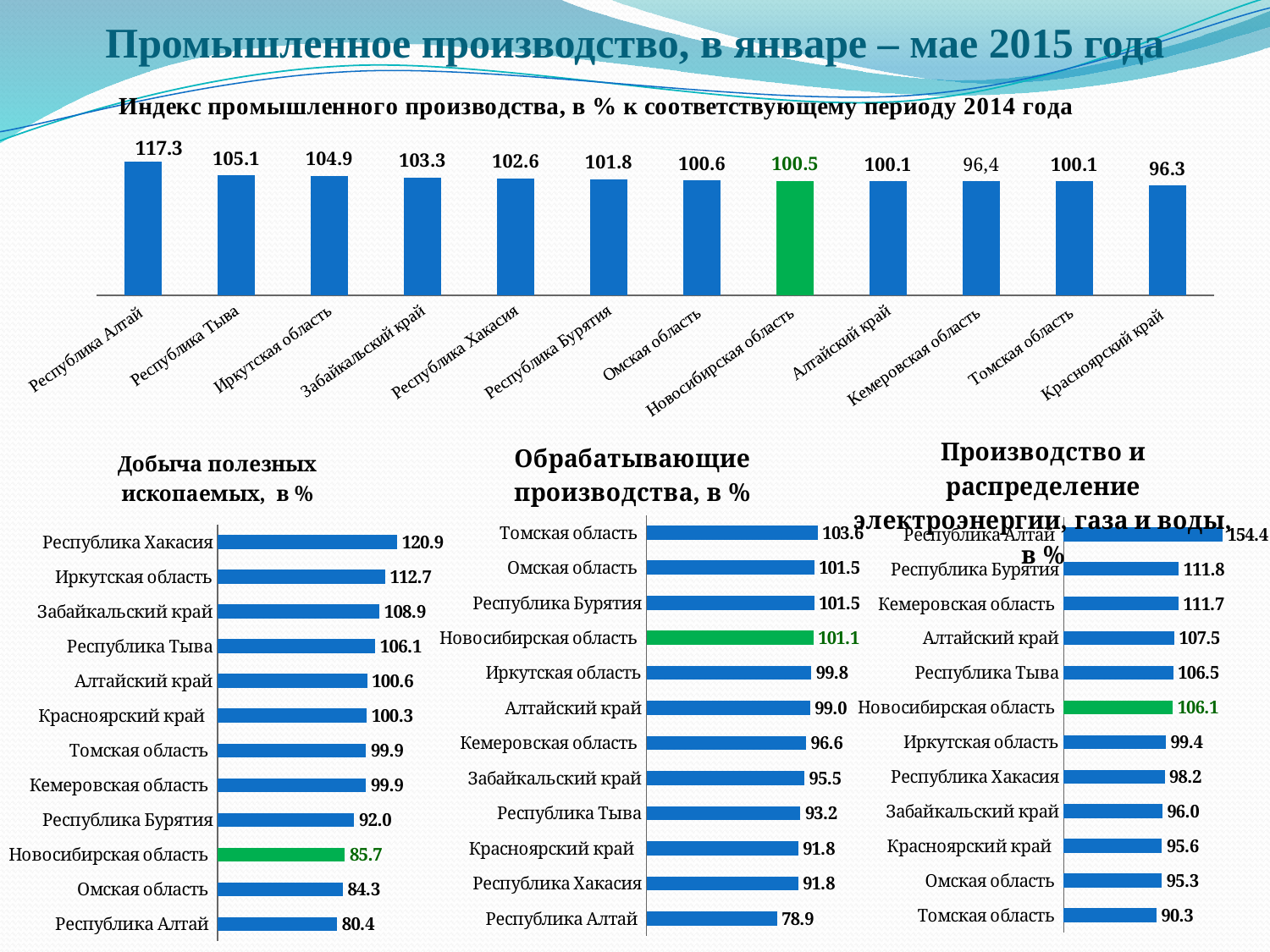
What type of chart is the top chart (Индекс промышленного производства)? Bar chart On the top chart (Индекс промышленного производства), what is the value for Республика Алтай? 117.3 On the chart 'Добыча полезных ископаемых, в %', which region has the highest value? Республика Хакасия On the chart 'Производство и распределение электроэнергии, газа и воды, в %', which is larger: Республика Бурятия or Томская область? Республика Бурятия On the chart 'Добыча полезных ископаемых, в %', what is the value for Новосибирская область? 85.7 On the top chart (Индекс промышленного производства), what is the value for Новосибирская область? 100.5 On the top chart (Индекс промышленного производства), how many regions are shown? 12 On the chart 'Производство и распределение электроэнергии, газа и воды, в %', what is the value for Республика Алтай? 154.4 On the top chart (Индекс промышленного производства), which region has the highest value? Республика Алтай On the chart 'Обрабатывающие производства, в %', what is the difference between Томская область and Республика Алтай? 24.7 On the chart 'Добыча полезных ископаемых, в %', which region has the lowest value? Республика Алтай On the chart 'Обрабатывающие производства, в %', what is the value for Томская область? 103.6